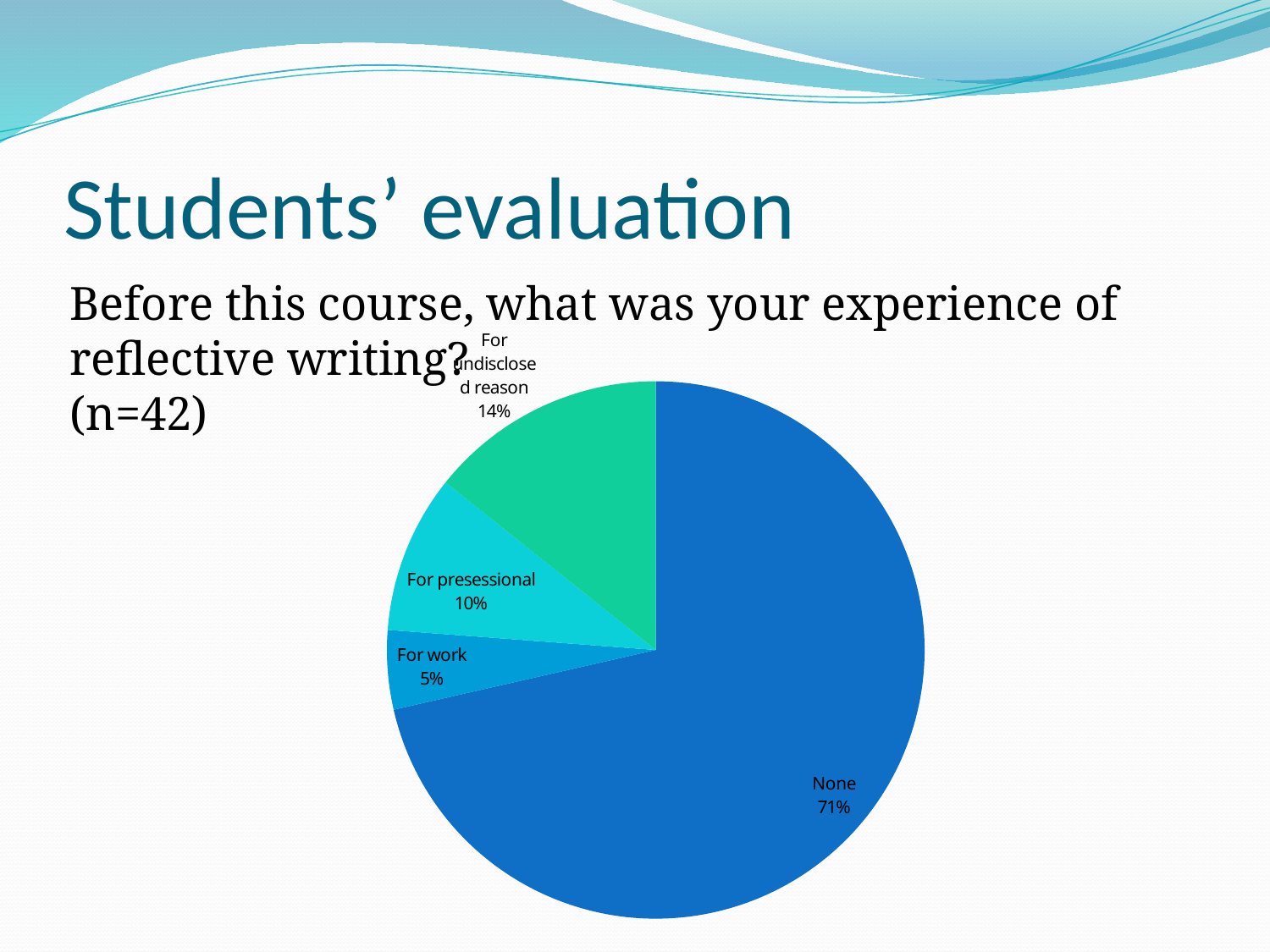
What is the sample size (n) stated for the survey question on the slide? 42 What is the difference in percentage points between "None" and "For undisclosed reason"? 57 Which category has the smallest slice of the pie? For work What share of the pie is labelled "None"? 71% Which is larger, the slice for "For presessional" or the slice for "For undisclosed reason"? For undisclosed reason What percentage is shown for "For undisclosed reason"? 14% What percentage is shown for "For presessional"? 10% How many slices does the pie chart have? 4 What percentage is shown for "For work"? 5% Which category has the largest slice of the pie? None What is the difference in percentage points between "For presessional" and "For work"? 5 What kind of chart is shown on the slide? Pie chart